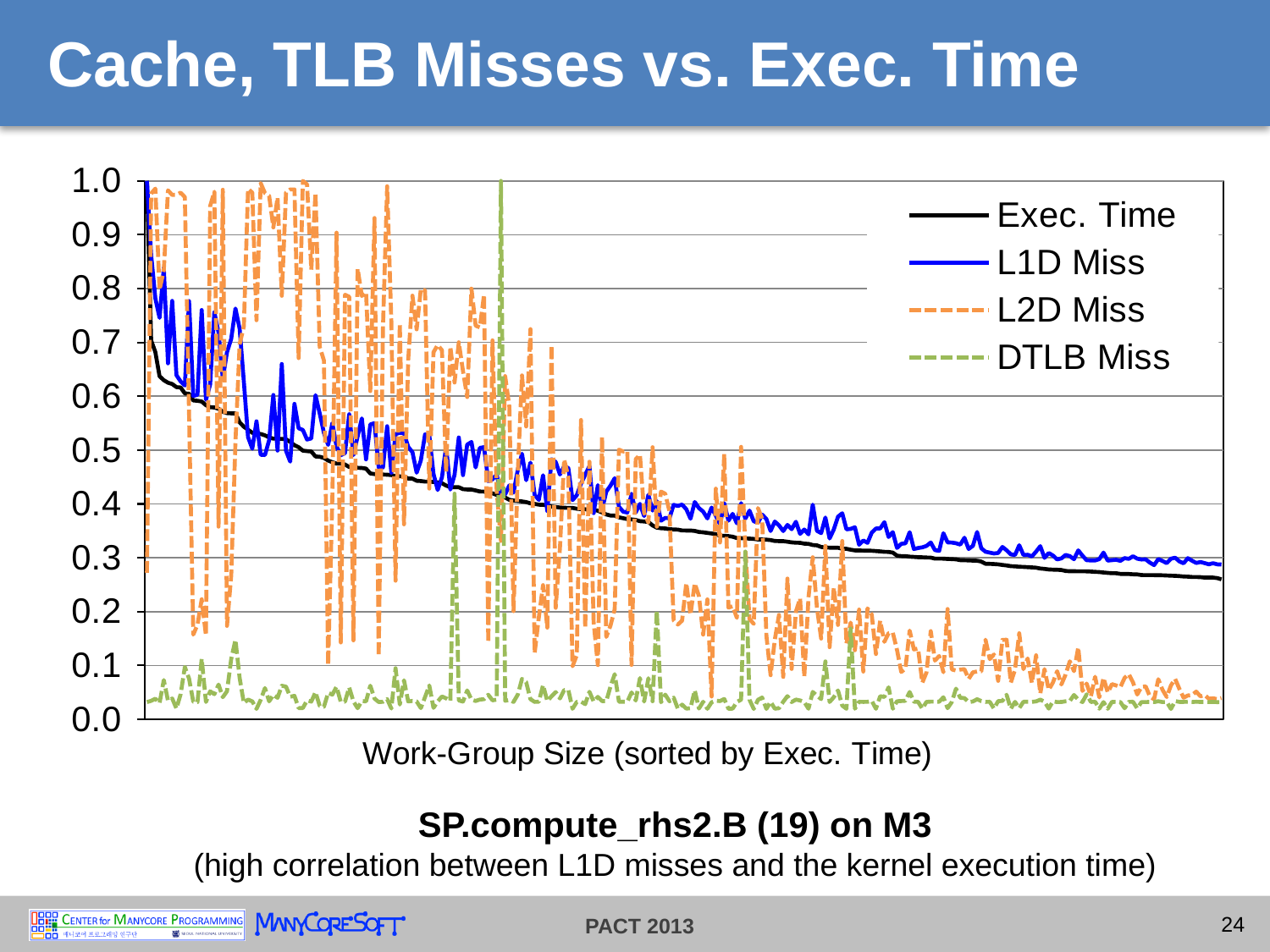
At the far left end of the x axis, is the Exec. Time value greater or less than 0.9? greater What is the label of the x axis? Work-Group Size (sorted by Exec. Time) At the far right end of the x axis, is the L1D Miss value greater or less than 0.2? greater At the far right end of the x axis, is the Exec. Time value greater or less than 0.3? less Which series are listed in the legend? Exec. Time, L1D Miss, L2D Miss, DTLB Miss Does the L1D Miss line generally rise or fall along the x axis? fall Does the Exec. Time line rise or fall along the x axis? fall What is the highest value shown on the y axis? 1.0 At the far right end of the x axis, which is higher, the L1D Miss line or the Exec. Time line? L1D Miss How many series does the legend list? 4 Which series stays lowest across most of the x axis? DTLB Miss What kind of chart is shown on the slide? line chart